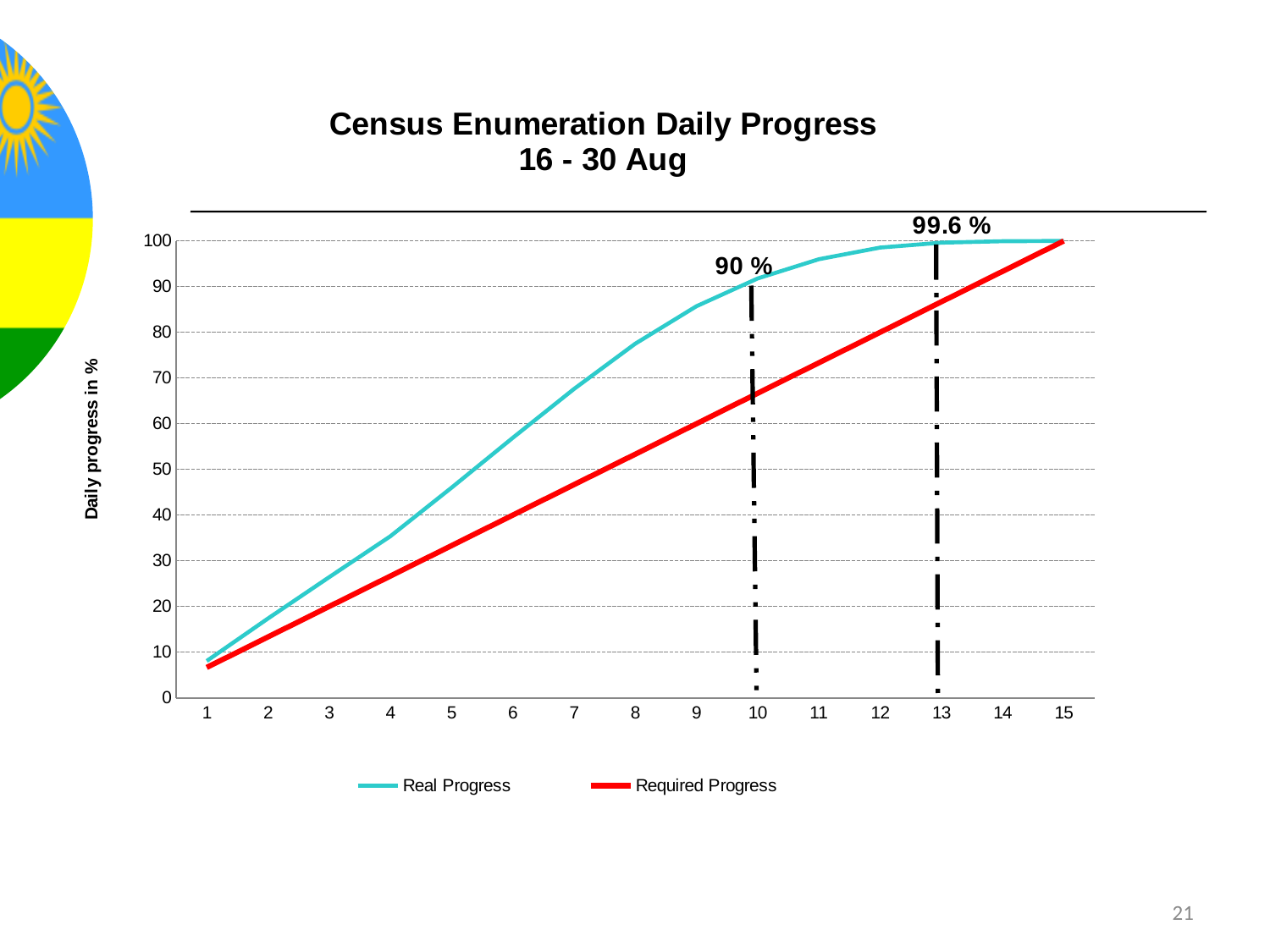
What kind of chart is shown on the slide? line chart What is the title of the y axis? Daily progress in % What is the Real Progress value labelled at day 10? 90 % Is the Real Progress value at day 8 greater or less than 70? greater At day 10, which is larger: Real Progress or Required Progress? Real Progress Is the Required Progress value at day 10 greater or less than 80? less By how many percentage points does the labelled Real Progress at day 13 exceed the labelled value at day 10? 9.6 Does the Real Progress line rise or fall from day 1 to day 15? rise How many series does the legend list? 2 What are the two series named in the legend? Real Progress and Required Progress How many days are shown along the x axis? 15 What is the Real Progress value labelled at day 13? 99.6 %